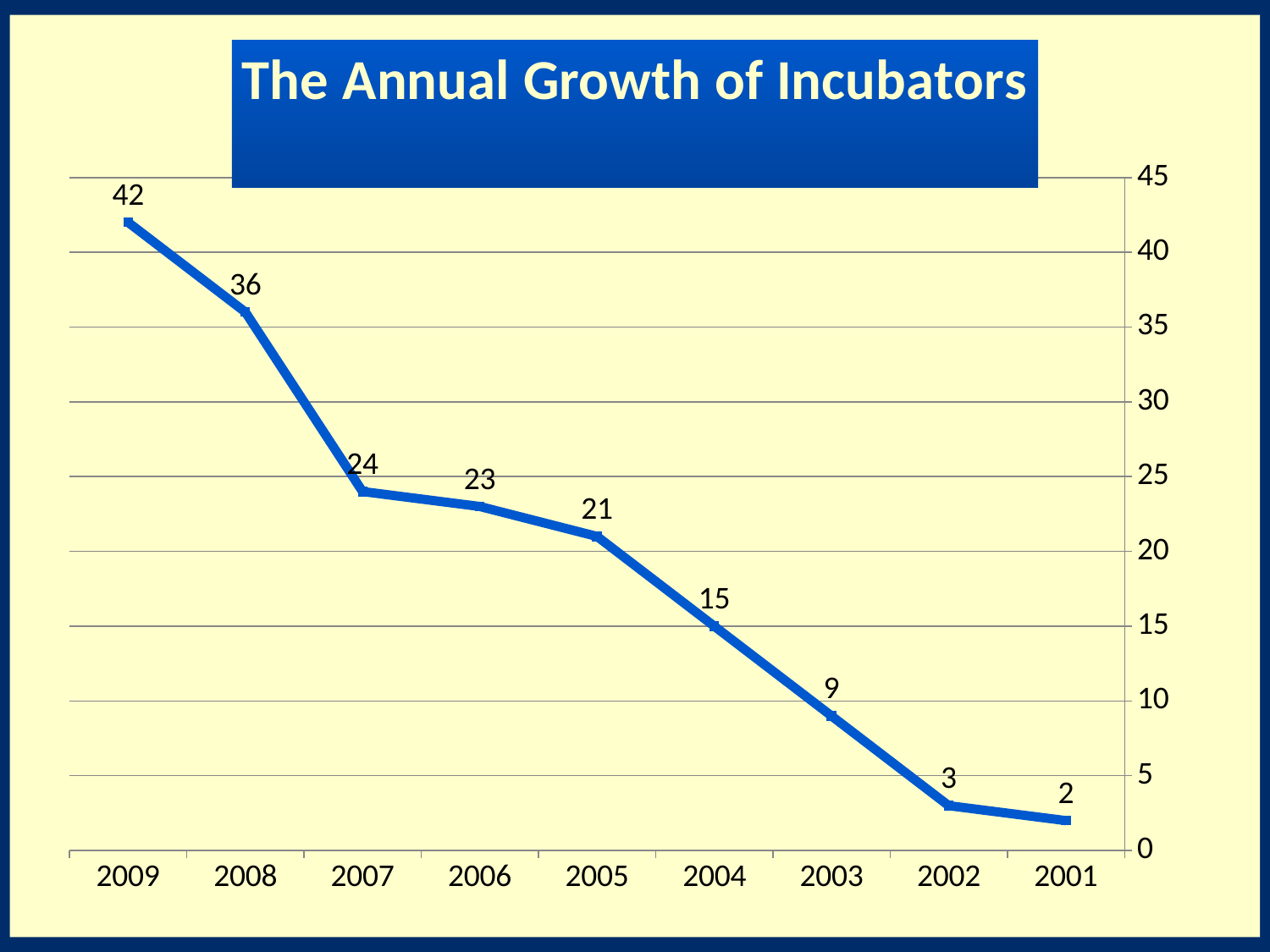
What is the difference between the values for 2005 and 2003? 12 What is the value for 2001? 2 What is the value for 2009? 42 What kind of chart is shown on the slide? line chart Is the value for 2008 greater or less than 30? greater Which year has the lowest value? 2001 How many years are plotted on the chart? 9 Which year has the highest value? 2009 What is the difference between the values for 2009 and 2008? 6 Which is larger, the value for 2007 or the value for 2006? 2007 What is the title of the chart? The Annual Growth of Incubators What is the value for 2004? 15